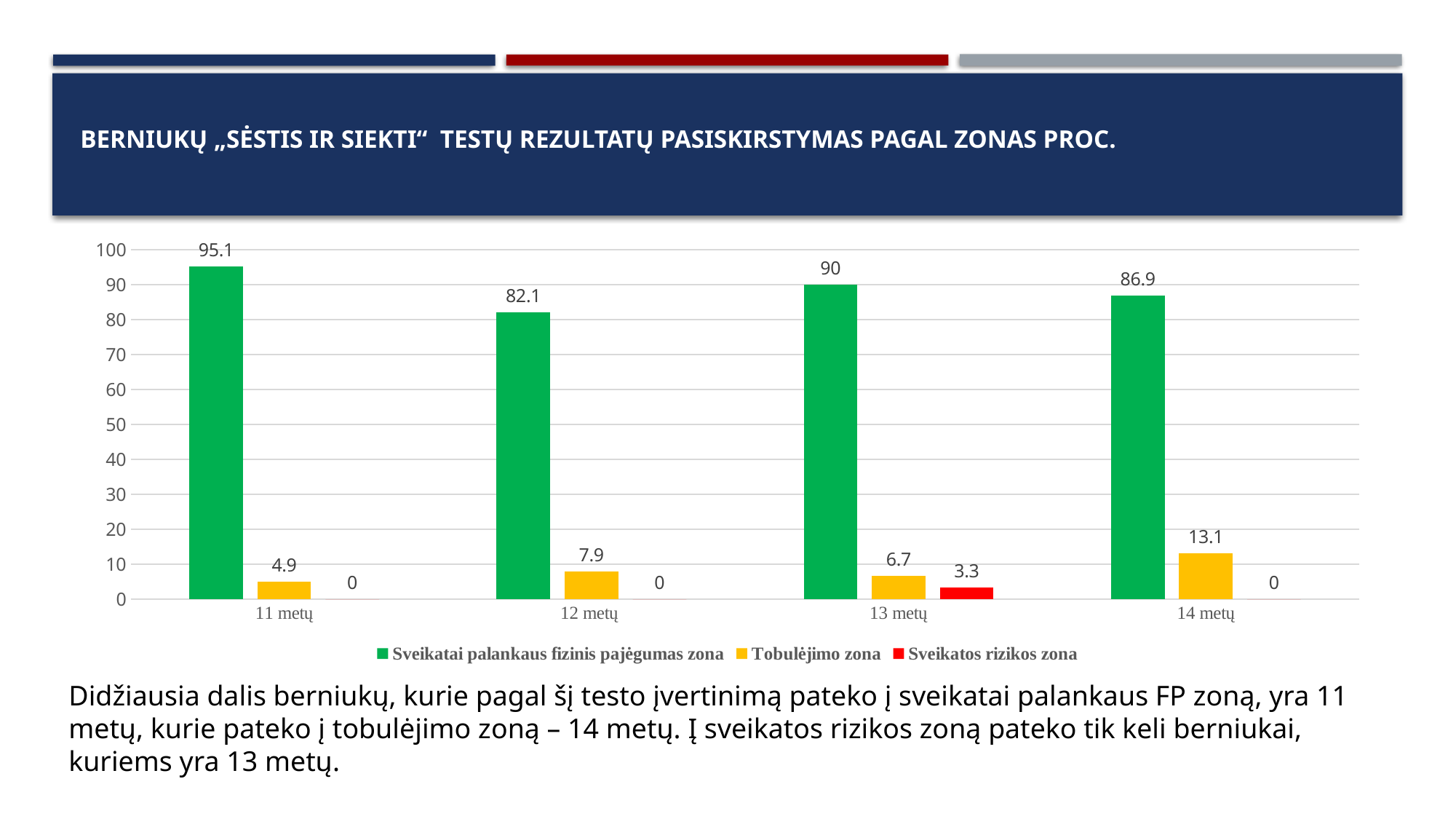
Which colour represents "Sveikatos rizikos zona" in the chart? red Is the value of "Sveikatai palankaus fizinis pajėgumas zona" for 14 metų greater or less than 80? greater What is the value of "Sveikatos rizikos zona" for 13 metų? 3.3 Which is larger: the "Tobulėjimo zona" value for 12 metų or for 13 metų? 12 metų What is the value of "Sveikatai palankaus fizinis pajėgumas zona" for 11 metų? 95.1 How many age groups are shown on the x axis? 4 What kind of chart is shown on the slide? bar chart What is the difference between the "Sveikatai palankaus fizinis pajėgumas zona" values for 11 metų and 12 metų? 13 How many series does the legend list? 3 What is the value of "Tobulėjimo zona" for 14 metų? 13.1 Which age group has the highest value for "Sveikatai palankaus fizinis pajėgumas zona"? 11 metų Which age group has the lowest value for "Tobulėjimo zona"? 11 metų